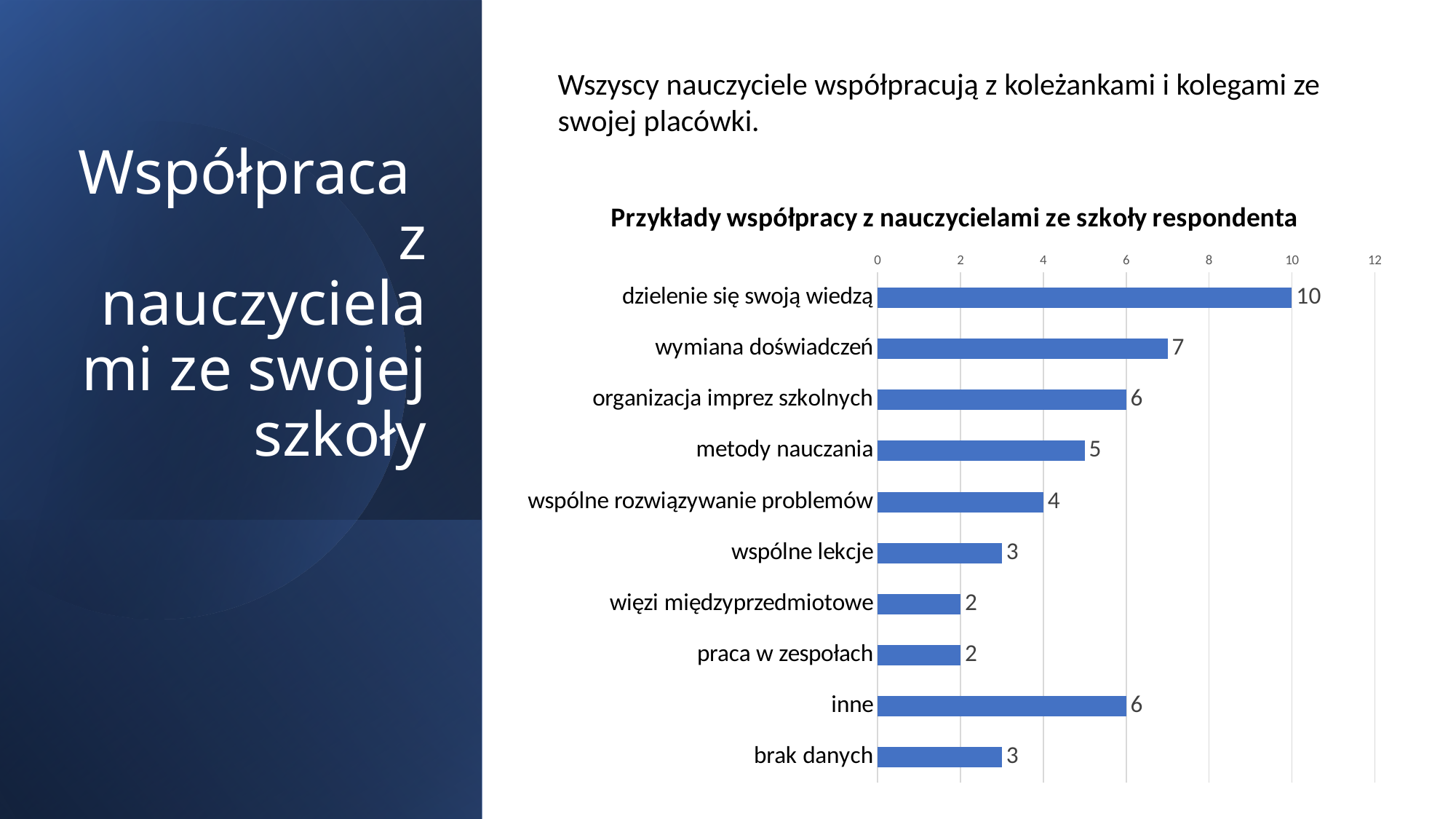
What kind of chart is shown on the slide? bar chart What is the value for "brak danych"? 3 How many categories are shown in the chart? 10 What is the value for "dzielenie się swoją wiedzą"? 10 Which two categories both have a value of 2? więzi międzyprzedmiotowe and praca w zespołach What is the title of the chart? Przykłady współpracy z nauczycielami ze szkoły respondenta What is the value for "wymiana doświadczeń"? 7 Is the value for "organizacja imprez szkolnych" greater or less than 4? greater What is the value for "wspólne rozwiązywanie problemów"? 4 Which category has the highest value? dzielenie się swoją wiedzą Which is larger, the value for "metody nauczania" or the value for "wspólne lekcje"? metody nauczania What is the difference between the values for "dzielenie się swoją wiedzą" and "wymiana doświadczeń"? 3